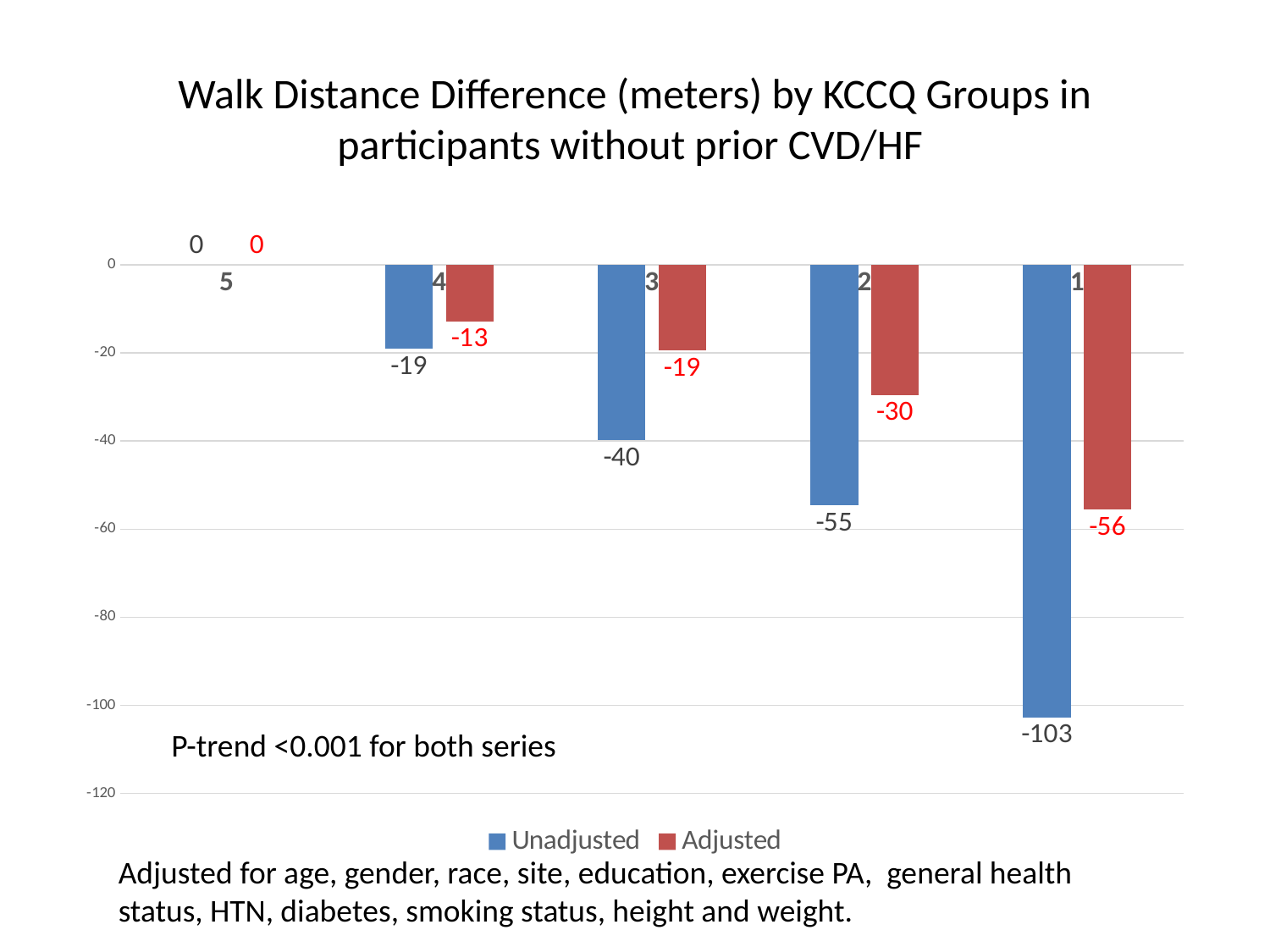
Which KCCQ group has the lowest Unadjusted walk distance difference? 1 How many series does the legend list? 2 What is the Unadjusted walk distance difference for KCCQ group 3? -40 What kind of chart is shown on the slide? Bar chart How many KCCQ groups are shown on the x axis? 5 Which KCCQ group has the highest Adjusted walk distance difference? 5 Do the Unadjusted values rise or fall as the KCCQ group goes from 5 to 1? Fall What is the Adjusted walk distance difference for KCCQ group 2? -30 What is the difference between the Unadjusted and Adjusted values for KCCQ group 1? 47 What is the Adjusted value for KCCQ group 4? -13 What is the Unadjusted value for KCCQ group 1? -103 Which is larger, the Unadjusted value for group 2 or the Adjusted value for group 2? Adjusted value for group 2